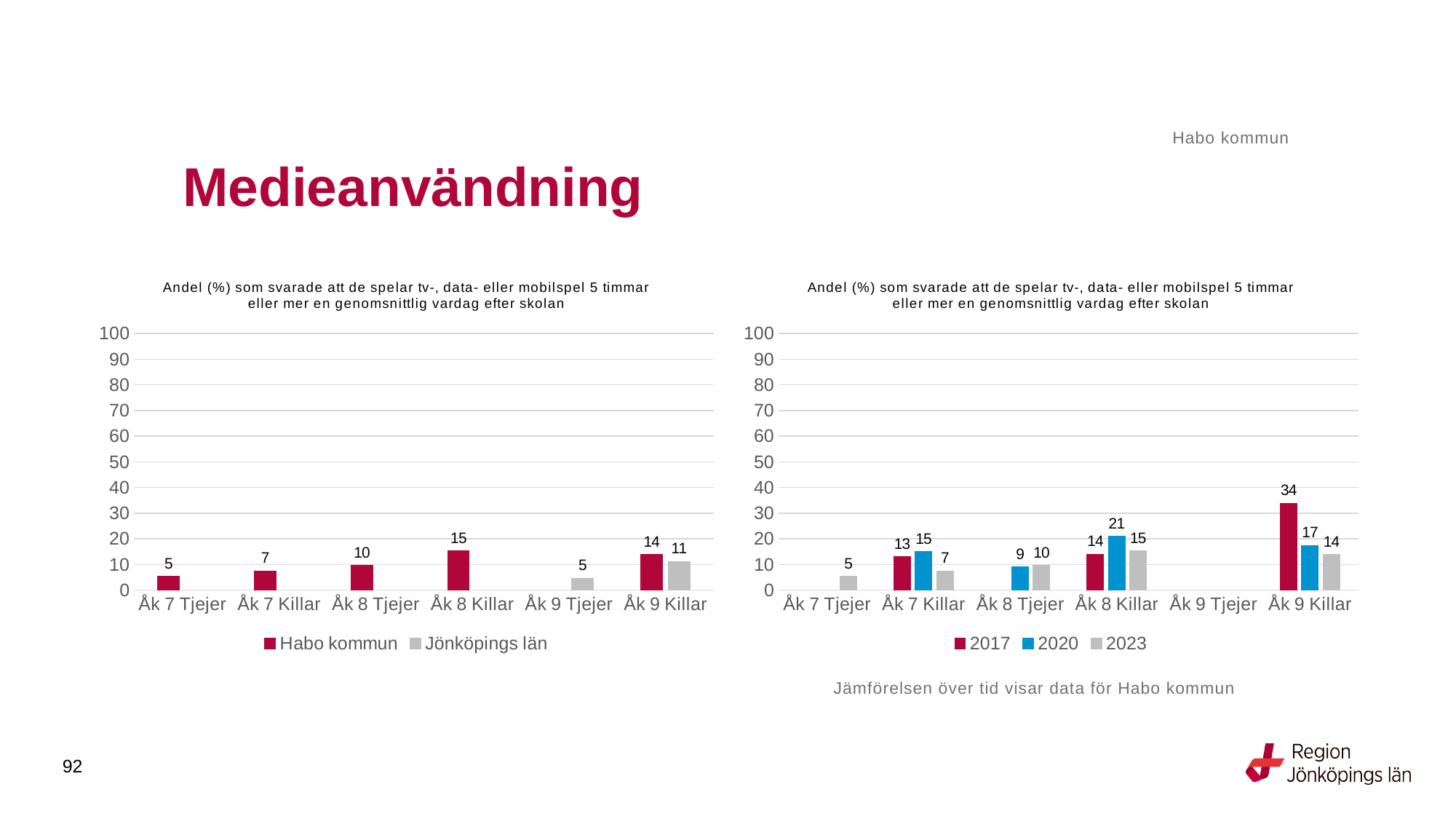
In the right chart, how many series does the legend list? 3 In the left chart, what is the value for Jönköpings län for Åk 9 Killar? 11 In the left chart, which category has the highest Habo kommun value? Åk 8 Killar In the right chart, what is the 2017 value for Åk 9 Killar? 34 In the right chart, what is the 2020 value for Åk 8 Killar? 21 In the left chart, what is the difference between the Habo kommun and Jönköpings län values for Åk 9 Killar? 3 What type of chart is the right chart? bar chart In the right chart, which year has the highest value for Åk 9 Killar? 2017 In the left chart, what is the value for Habo kommun for Åk 8 Killar? 15 In the left chart, how many series does the legend list? 2 In the right chart, what is the difference between the 2017 and 2023 values for Åk 9 Killar? 20 In the right chart, is the 2020 value for Åk 7 Killar larger or smaller than the 2023 value for Åk 7 Killar? larger